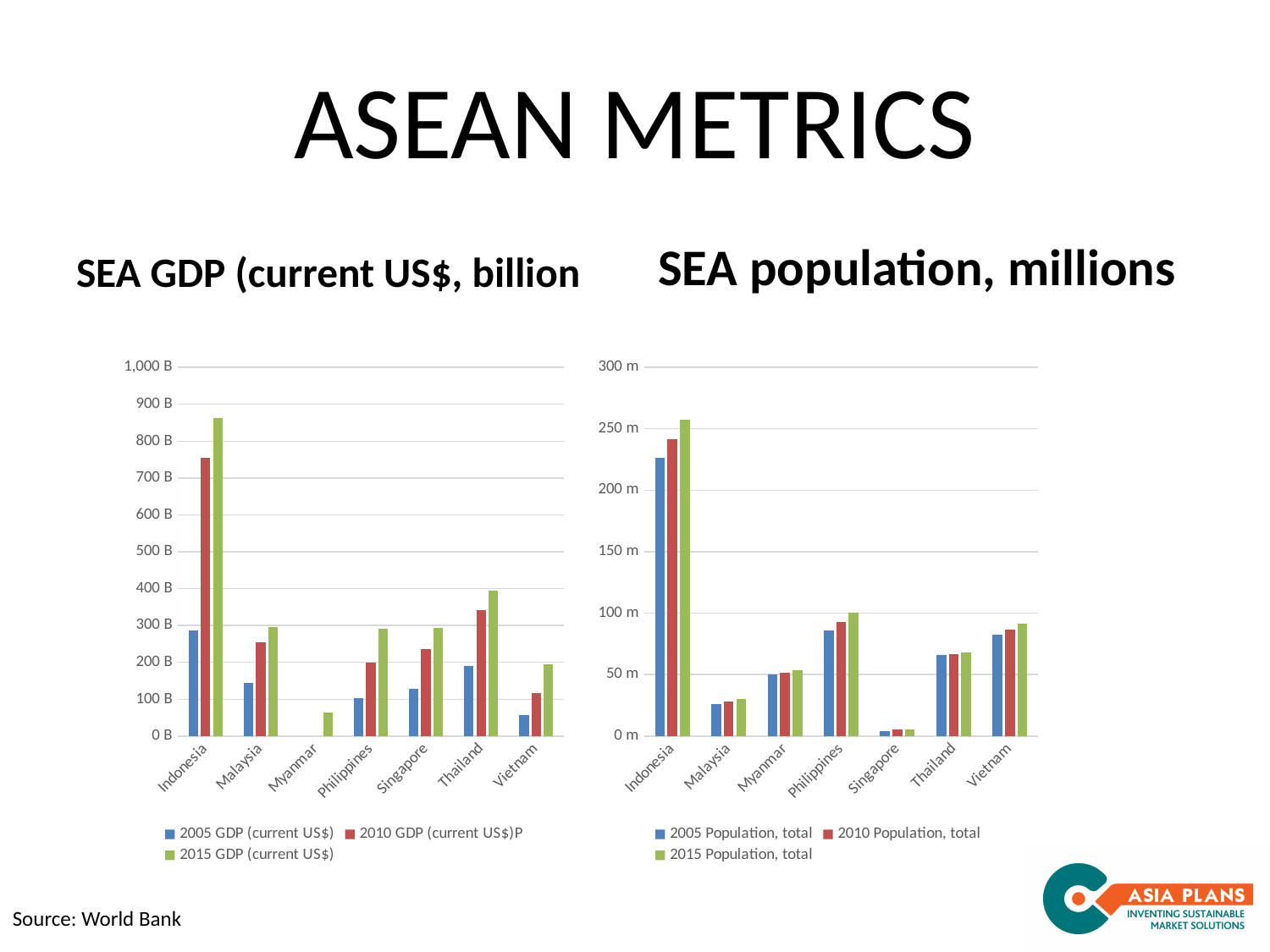
On the SEA population chart, is the 2005 population for Indonesia greater or less than 200 m? greater On the SEA GDP chart, which country has the highest 2015 GDP? Indonesia On the SEA GDP chart, is the 2015 GDP for Indonesia greater or less than 800 B? greater On the SEA population chart, which country has the highest 2005 population? Indonesia On the SEA population chart, how many countries are shown on the x axis? 7 On the SEA GDP chart, which is larger: the 2015 GDP of Thailand or the 2015 GDP of Vietnam? Thailand On the SEA GDP chart, is the 2015 GDP for Thailand greater or less than 300 B? greater On the SEA GDP chart, how many series does the legend list? 3 On the SEA GDP chart, do Indonesia's GDP values rise or fall from 2005 to 2015? rise On the SEA population chart, which country has the lowest 2015 population? Singapore What type of chart is the SEA population chart? bar chart